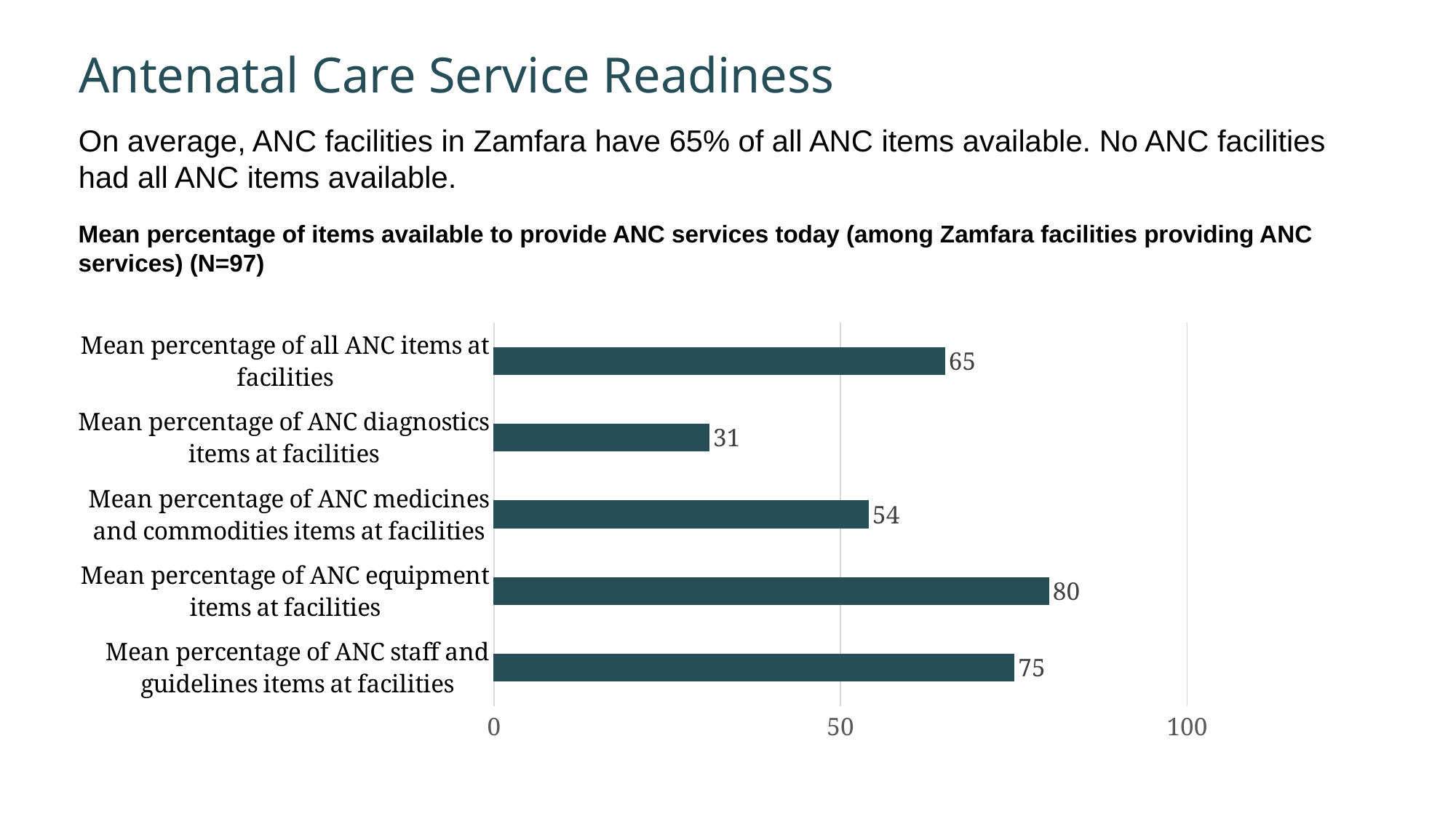
Which category has the highest mean percentage of items available? Mean percentage of ANC equipment items at facilities How many categories are shown in the chart? 5 What is the mean percentage of all ANC items at facilities? 65 Which category has the lowest mean percentage of items available? Mean percentage of ANC diagnostics items at facilities What is the mean percentage of ANC diagnostics items at facilities? 31 Which is larger: the mean percentage of ANC staff and guidelines items or the mean percentage of ANC medicines and commodities items? Mean percentage of ANC staff and guidelines items at facilities What kind of chart is shown on the slide? Bar chart What is the mean percentage of ANC staff and guidelines items at facilities? 75 Is the value for mean percentage of ANC diagnostics items at facilities greater or less than 50? less What is the mean percentage of ANC medicines and commodities items at facilities? 54 What is the mean percentage of ANC equipment items at facilities? 80 What is the difference between the mean percentage of ANC equipment items and the mean percentage of ANC diagnostics items? 49